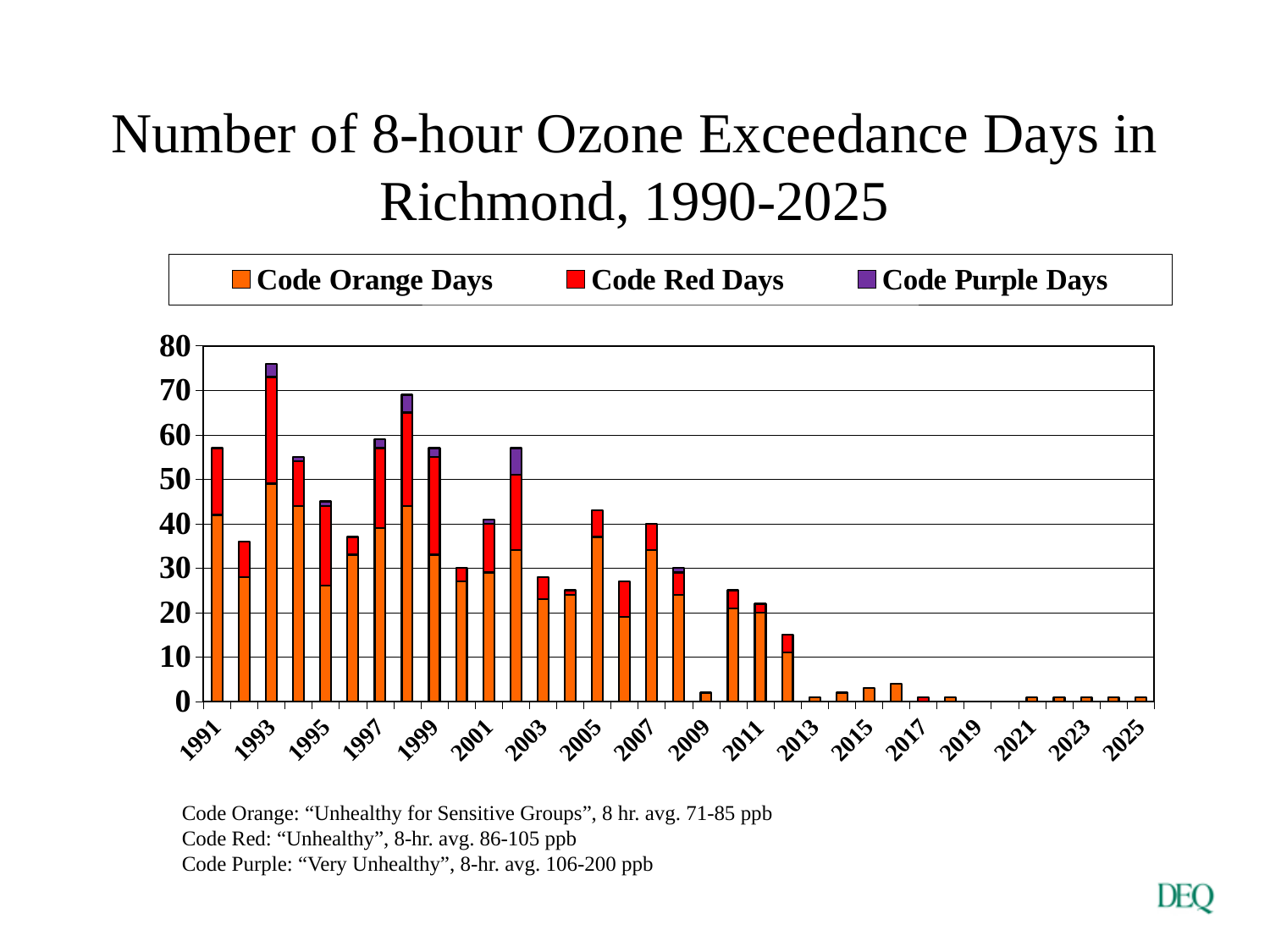
Overall, do the totals rise or fall from 1991 to 2025? fall Is the total for 2010 greater or less than 30? less Which year has the larger total, 2005 or 2006? 2005 Which year has the larger total, 1991 or 1992? 1991 Is the total for 2013 greater or less than 10? less Is the total for 1993 greater or less than 70? greater What is the title of the chart? Number of 8-hour Ozone Exceedance Days in Richmond, 1990-2025 Which year has the tallest stacked bar? 1993 How many year labels are shown on the x axis? 18 How many series does the legend list? 3 What kind of chart is shown on the slide? Stacked bar chart